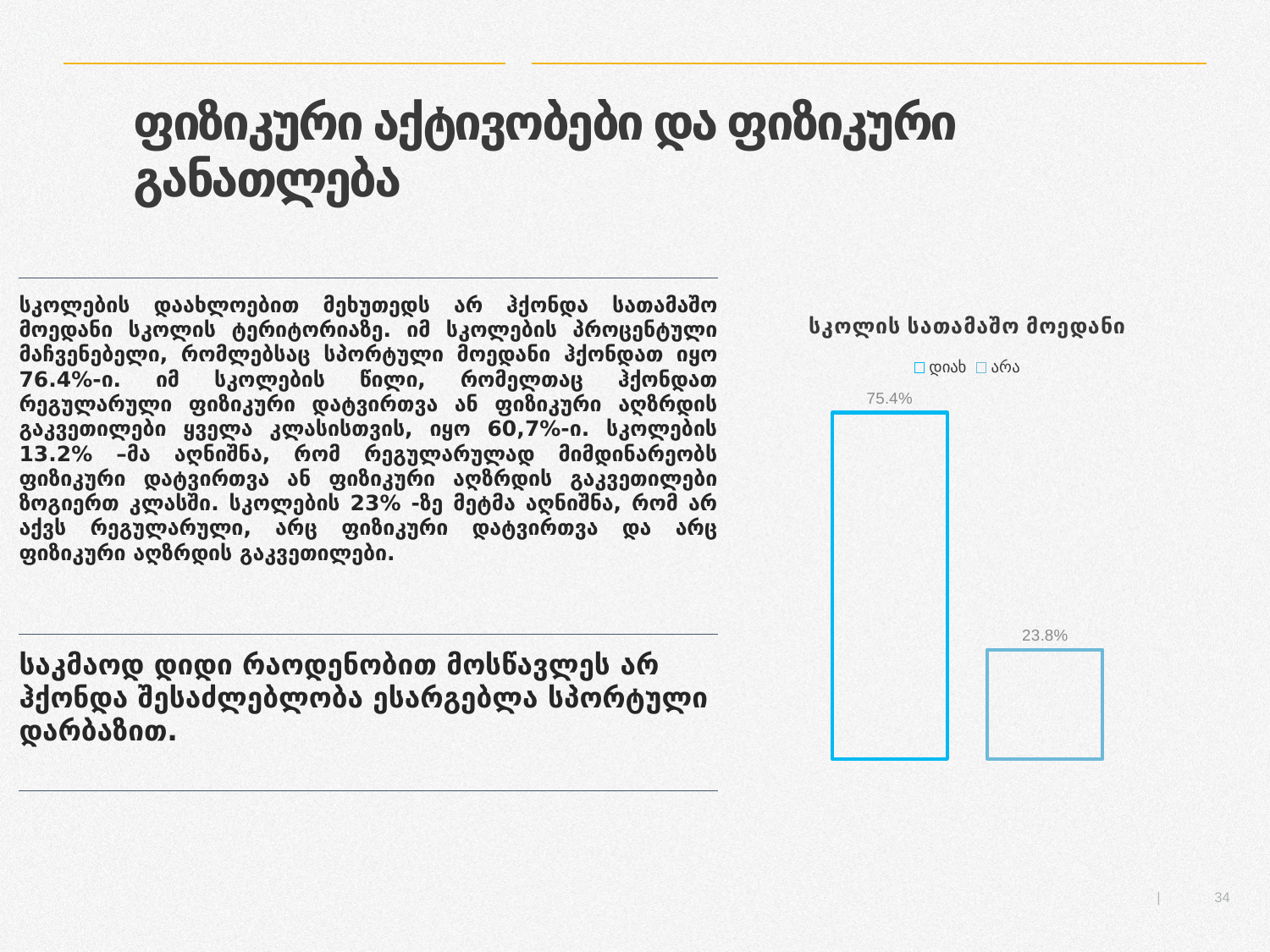
Which category has the lowest value in the chart? არა What is the difference between the values for დიახ and არა? 51.6% What is the title of the chart? სკოლის სათამაშო მოედანი How many bars are plotted in the chart? 2 What is the value for დიახ in the chart? 75.4% How many entries does the chart legend list? 2 What is the value for არა in the chart? 23.8% What are the two legend entries of the chart? დიახ and არა What kind of chart is shown on the slide? bar chart Which category has the highest value in the chart? დიახ Which is larger, the value for დიახ or the value for არა? დიახ